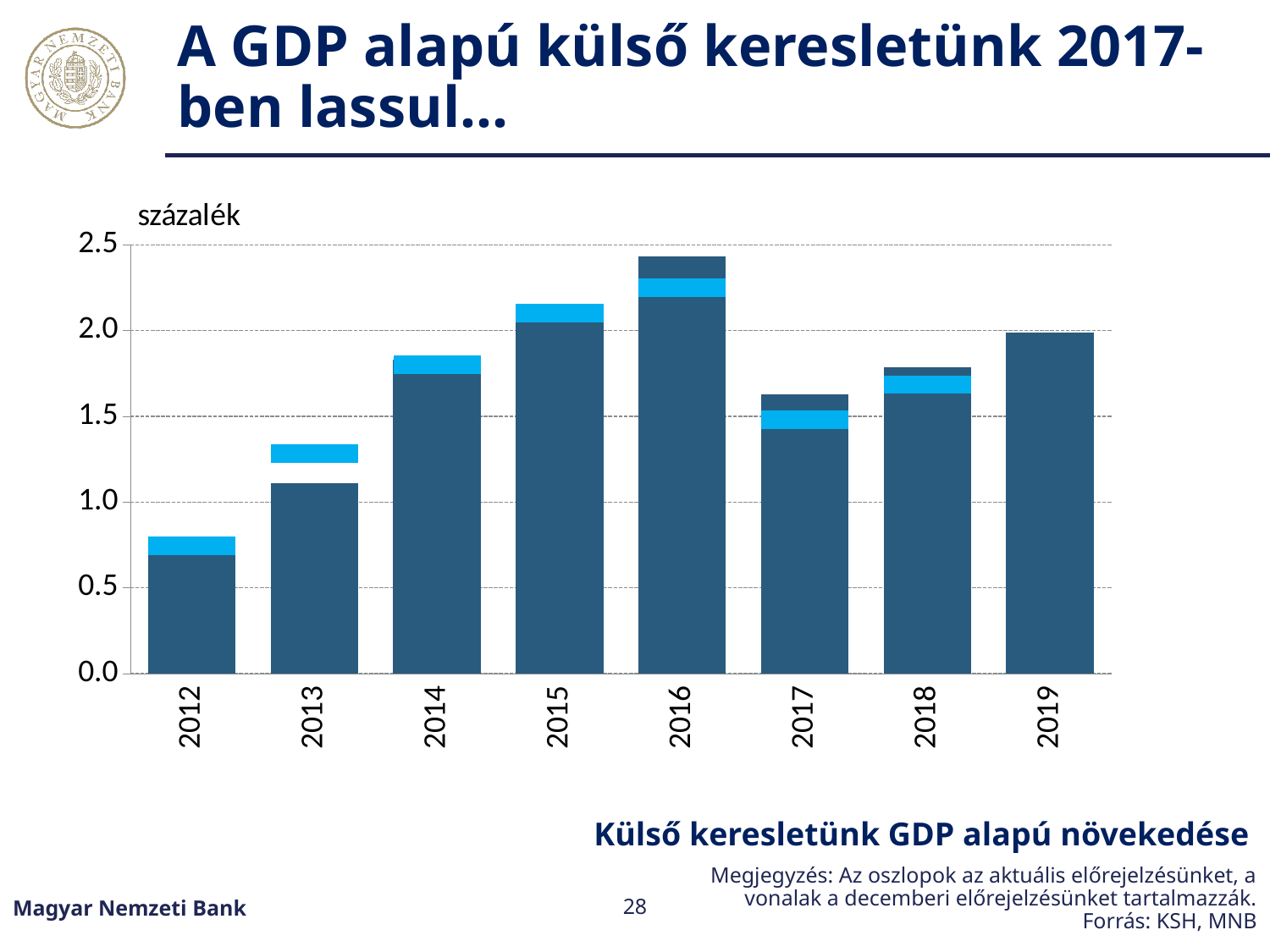
What kind of chart is shown on the slide? bar chart Which bar is taller, 2016 or 2017? 2016 Is the total bar value for 2013 greater or less than 1.0? greater Is the total bar value for 2012 greater or less than 1.0? less Do the bar values rise or fall from 2012 to 2016? rise Which year has the highest bar in the chart? 2016 How many years are shown on the x axis of the chart? 8 Which bar is taller, 2013 or 2014? 2014 Is the total bar value for 2018 greater or less than 2.0? less What unit label is shown above the y axis of the chart? százalék Which year has the lowest bar in the chart? 2012